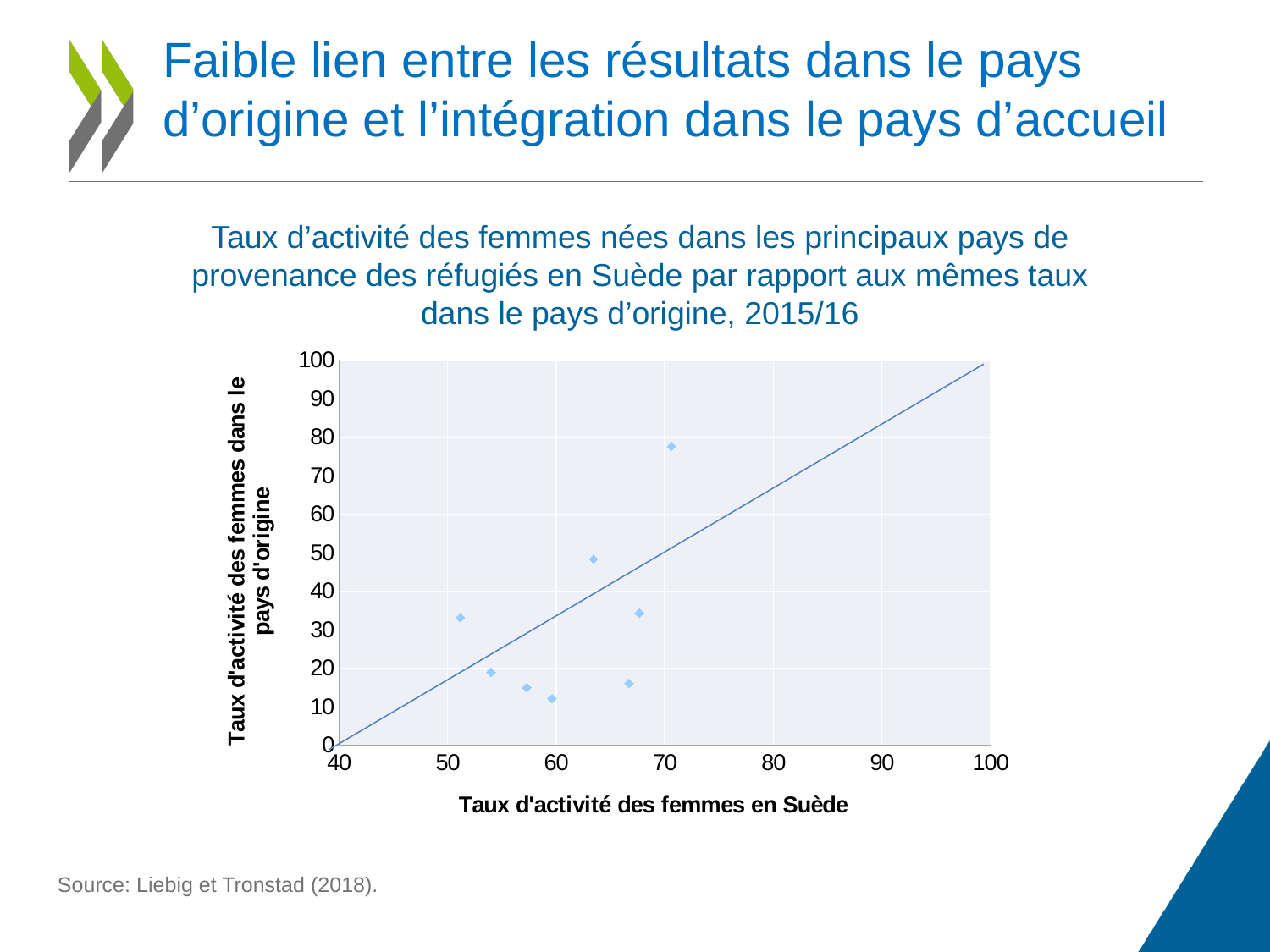
Are all the plotted points at horizontal-axis values less than 80? yes Is the horizontal-axis value of the leftmost point greater or less than 60? less What is the title of the horizontal axis of the chart? Taux d'activité des femmes en Suède How many data points are plotted in the scatter chart? 8 Is the vertical-axis value of the lowest point in the chart greater or less than 20? less What kind of chart is shown on the slide? scatter chart What is the title of the vertical axis of the chart? Taux d'activité des femmes dans le pays d'origine What is the lowest value shown on the horizontal axis? 40 What is the highest value shown on the vertical axis? 100